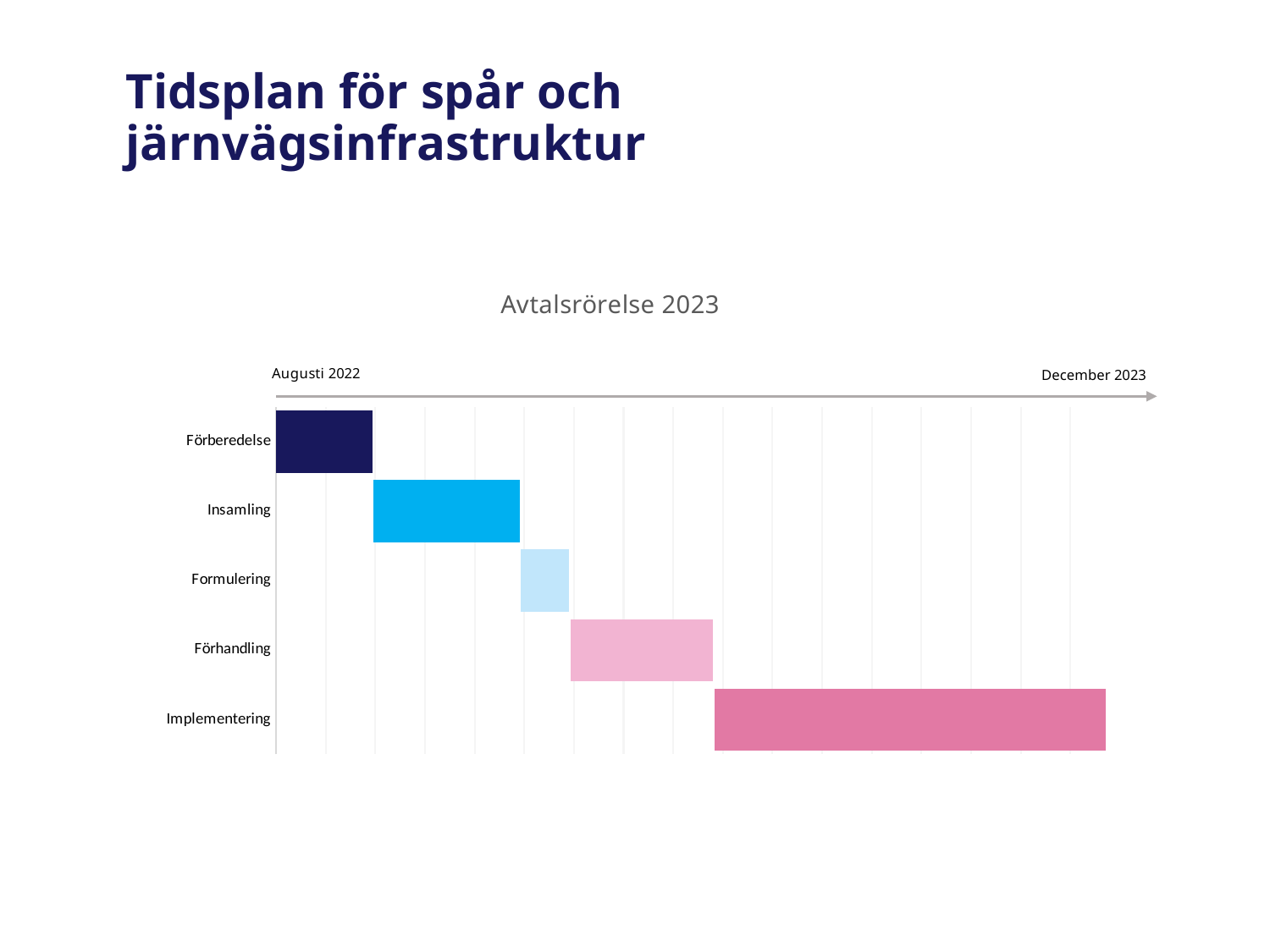
Which phase is listed first (at the top) of the chart? Förberedelse Which phase has the shortest bar on the chart? Formulering Which bar is longer, Implementering or Förhandling? Implementering Which bar is longer, Insamling or Formulering? Insamling Which phase starts earliest on the timeline? Förberedelse What is the title of the chart? Avtalsrörelse 2023 Which phase ends latest on the timeline? Implementering Which phase has the longest bar on the chart? Implementering What kind of chart is shown on the slide? Bar chart (Gantt-style horizontal bars) How many phases (categories) are listed on the chart? 5